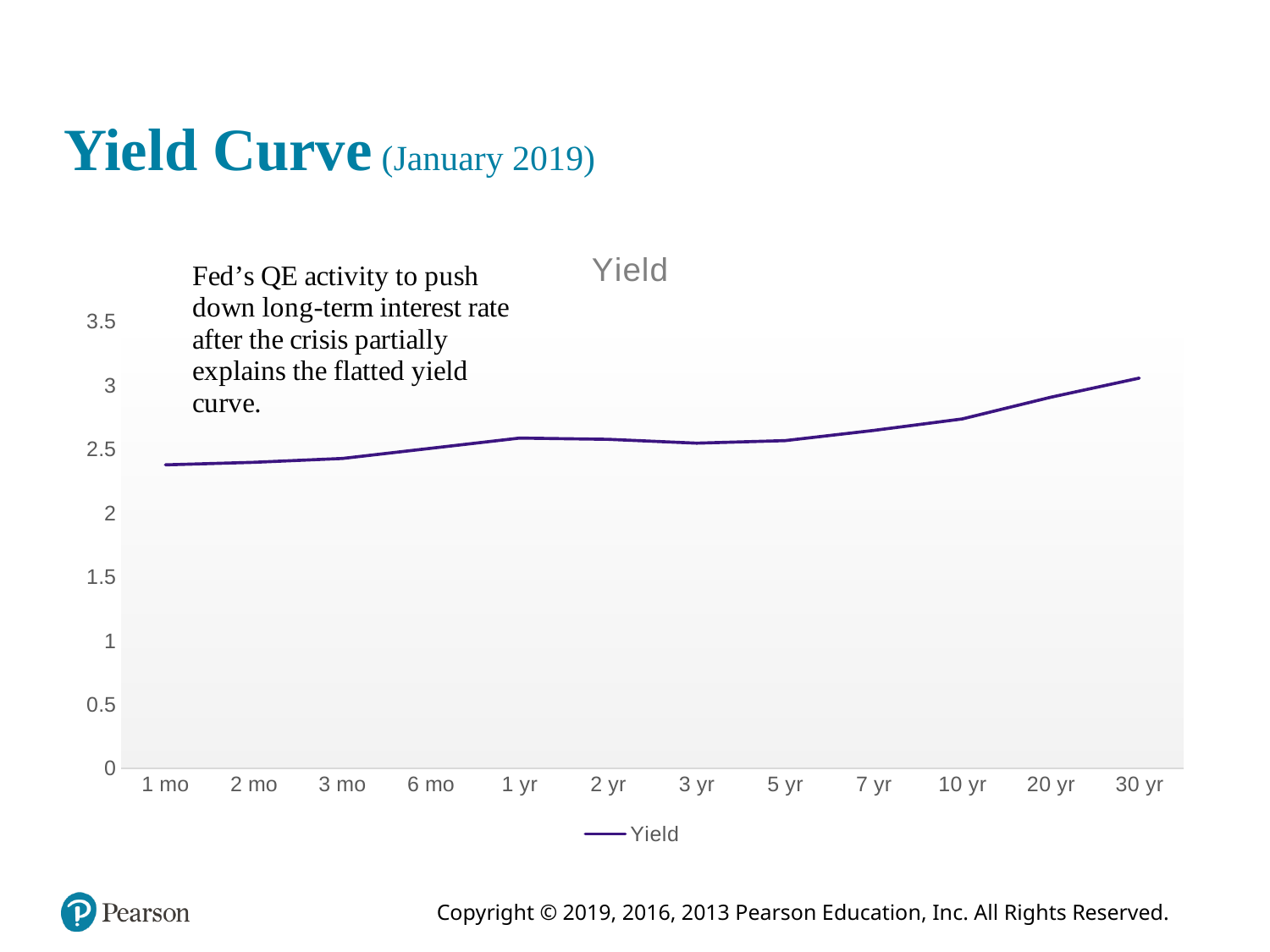
Which has the higher yield, 30 yr or 1 mo? 30 yr How many maturities are plotted along the x axis of the Yield chart? 12 How many series does the legend of the Yield chart list? 1 Is the yield for 20 yr greater or less than 3? less Overall, does the yield rise or fall as maturity increases from 1 mo to 30 yr? rise What kind of chart is shown on the slide? line chart What is the title shown above the chart? Yield Which has the higher yield, 10 yr or 3 yr? 10 yr Is the yield for 30 yr greater or less than 3? greater Which maturity has the highest yield in the chart? 30 yr Is the yield for 10 yr greater or less than 2.5? greater